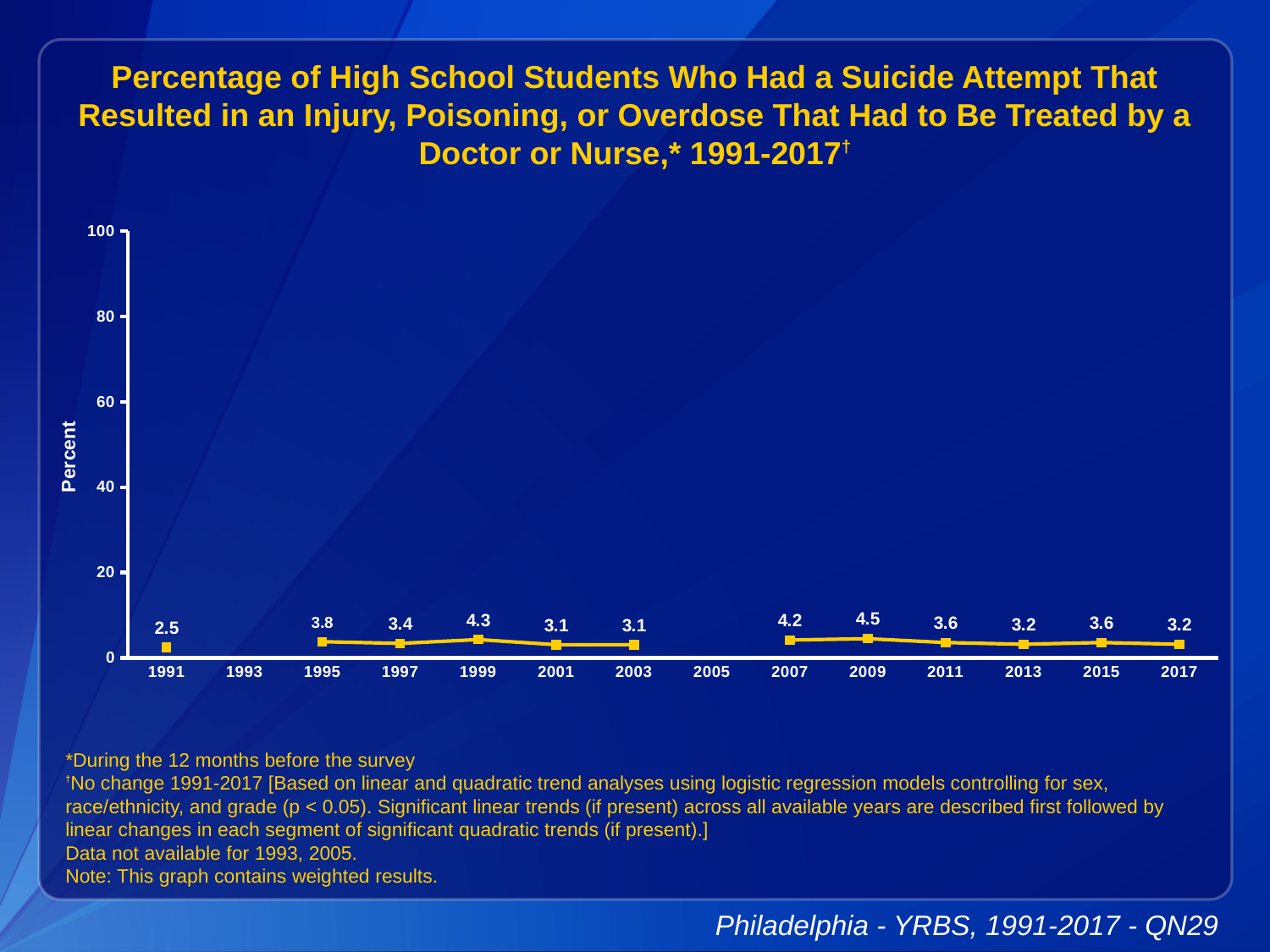
What is the difference between the values for 1999 and 2001? 1.2 What is the value for 2017? 3.2 What is the value for 1991? 2.5 Which year has the highest value? 2009 What is the value for 2009? 4.5 Which two years are noted as having no data available? 1993, 2005 How many data points are plotted on the chart? 12 What kind of chart is shown? line chart Is the value for 2013 greater or less than 20? less Which is larger, the value for 2007 or the value for 2011? 2007 What is the label of the y axis? Percent Which year has the lowest value? 1991